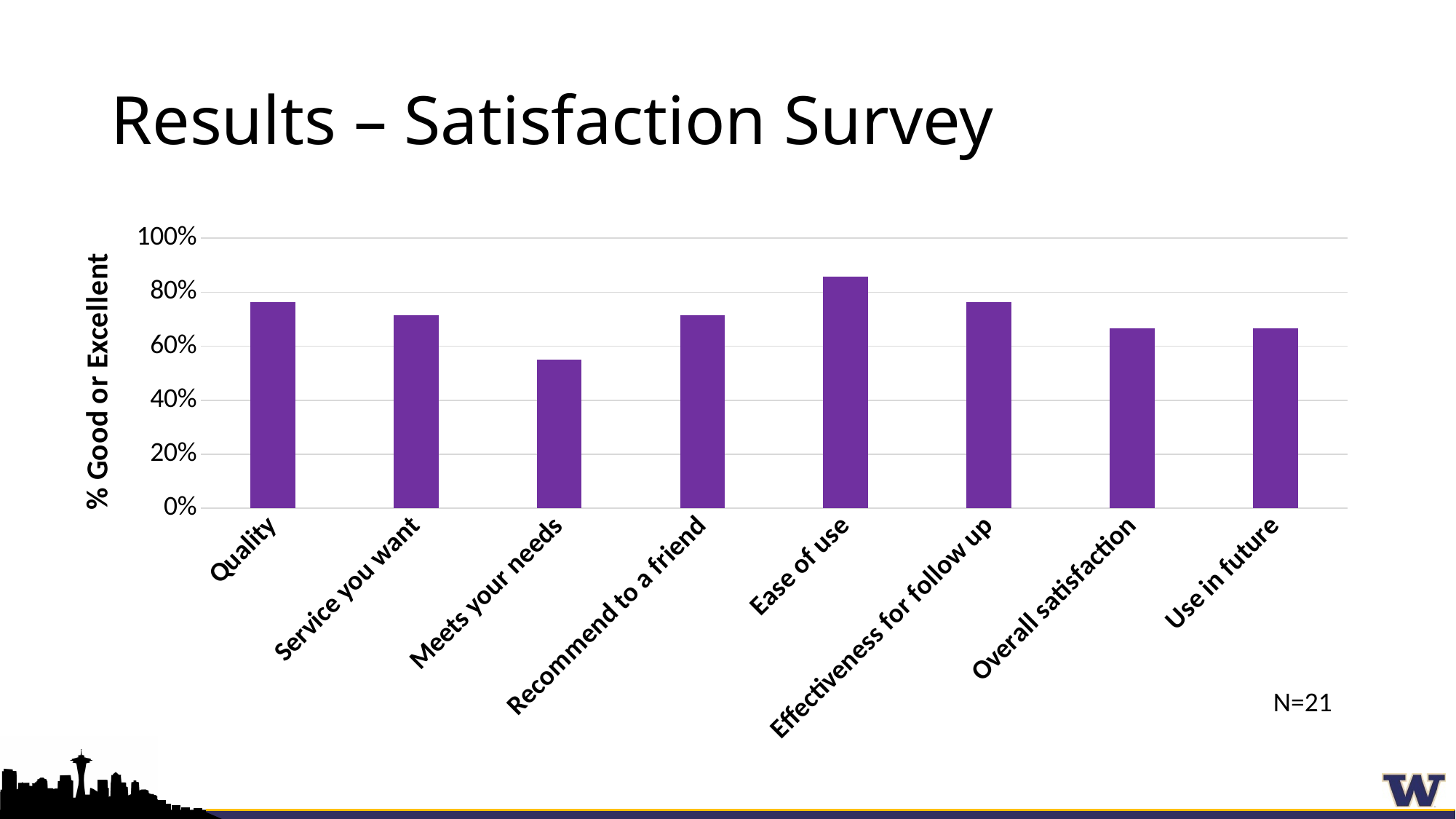
Is the value for Quality greater or less than 60%? greater How many categories are plotted in the chart? 8 Which category has the highest value in the chart? Ease of use Which category has the lowest value in the chart? Meets your needs Which is larger, the value for Quality or the value for Use in future? Quality What is the title of the vertical axis of the chart? % Good or Excellent Is the value for Meets your needs greater or less than 60%? less Which is larger, the value for Ease of use or the value for Meets your needs? Ease of use Is the value for Overall satisfaction greater or less than 80%? less What kind of chart is shown on the slide? bar chart What sample size (N) is noted below the chart? N=21